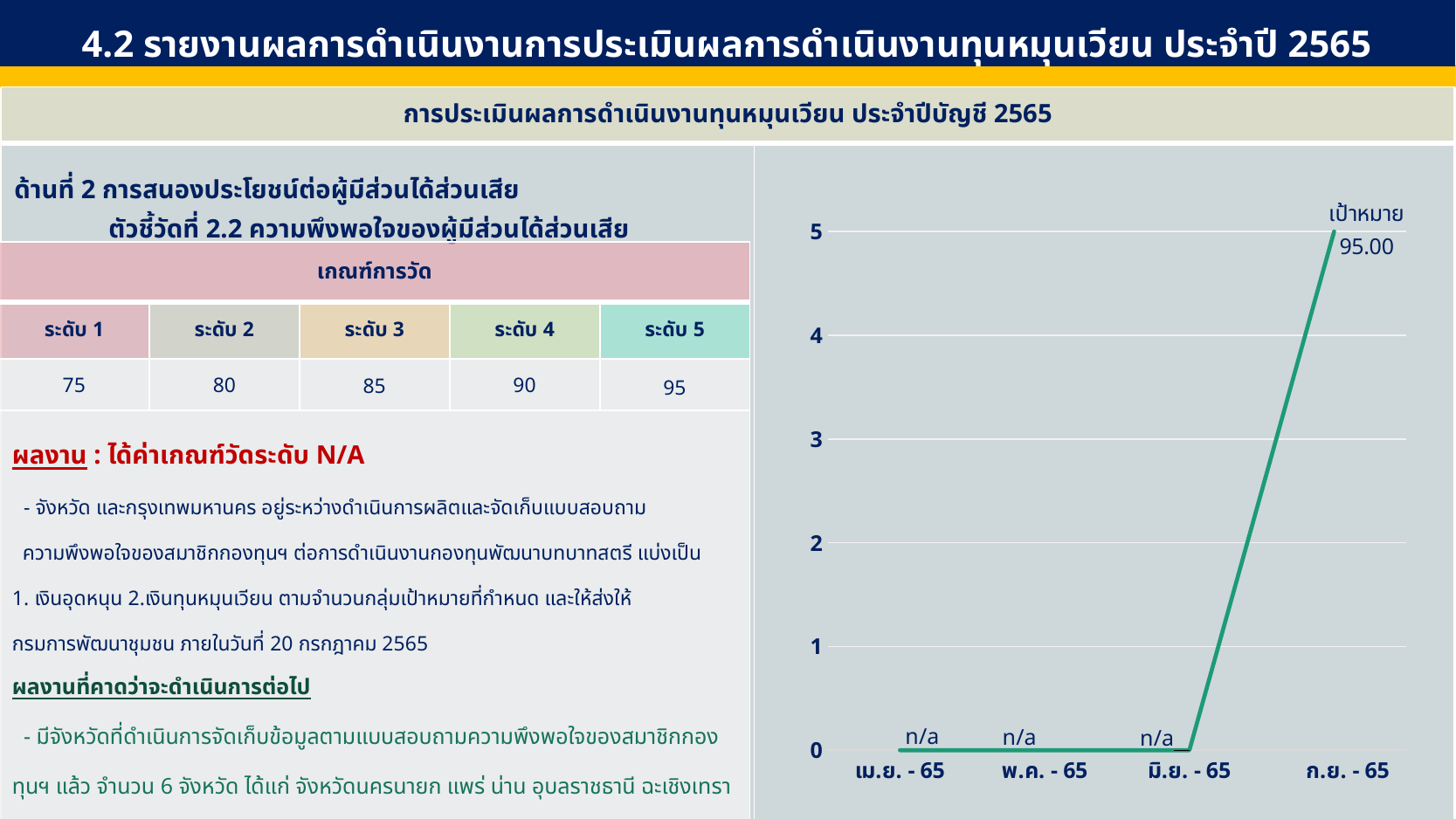
What is the highest value shown on the y axis of the chart? 5 What is the data label shown for พ.ค. - 65 in the chart? n/a What word is printed above the last point of the line in the chart? เป้าหมาย Is the point for ก.ย. - 65 on the chart greater or less than 4 on the y axis? greater What kind of chart is shown on the right side of the slide? line chart Is the point for มิ.ย. - 65 on the chart greater or less than 1 on the y axis? less What value is printed next to the point for ก.ย. - 65 in the chart? 95.00 What is the data label shown for มิ.ย. - 65 in the chart? n/a What is the data label shown for เม.ย. - 65 in the chart? n/a How many categories are shown on the x axis of the chart? 4 Which category on the x axis has the highest point on the line? ก.ย. - 65 Does the line rise or fall between มิ.ย. - 65 and ก.ย. - 65? rise